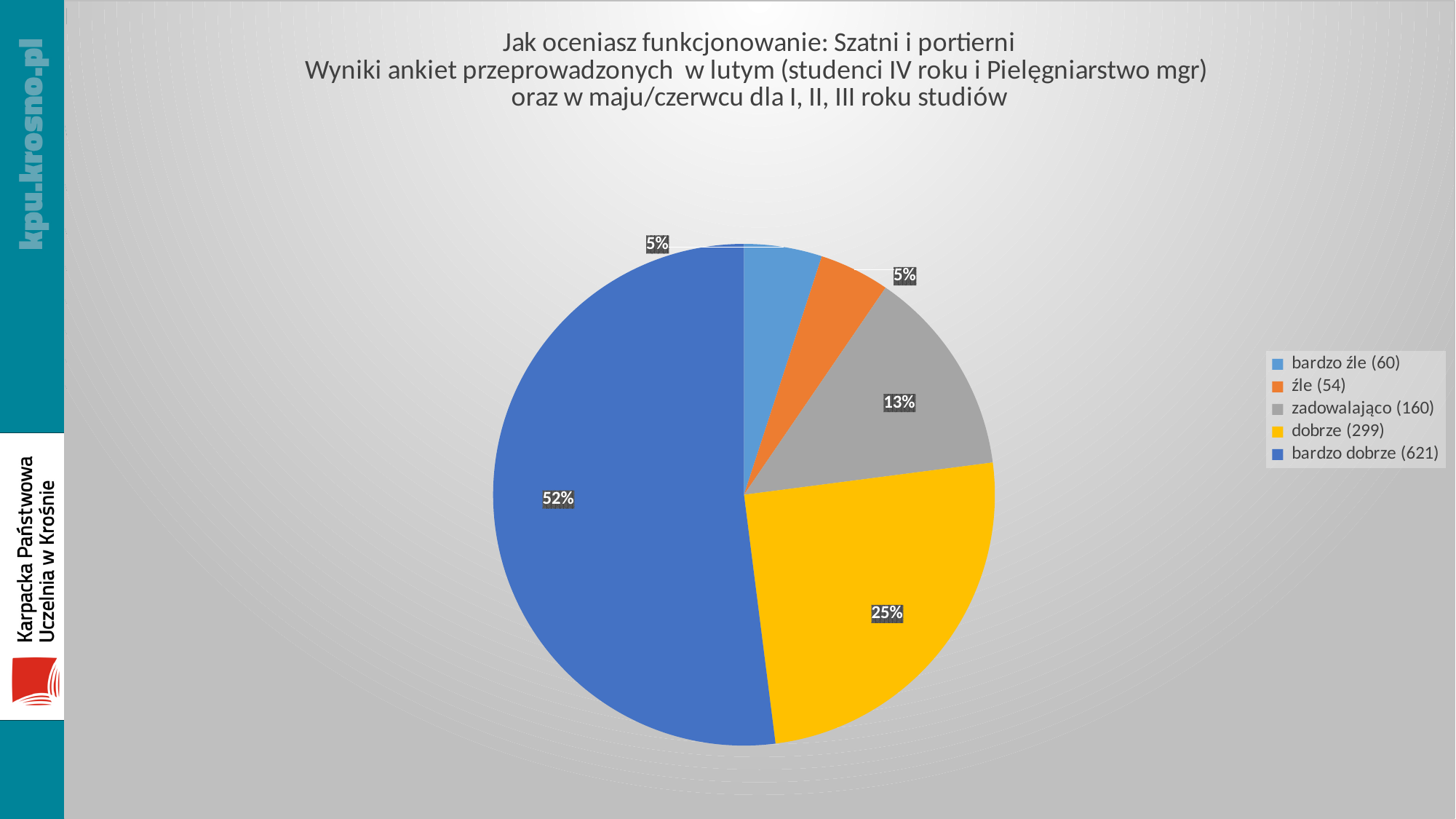
How many slices does the pie chart have? 5 Which slice is larger, "dobrze" or "zadowalająco"? dobrze Which category has the largest slice of the pie? bardzo dobrze What percentage share does the "bardzo dobrze" slice have? 52% What is the difference in percentage points between the "bardzo dobrze" and "dobrze" slices? 27 What kind of chart is shown on the slide? pie chart What colour is the "dobrze" slice? yellow What percentage share does the "zadowalająco" slice have? 13% How many responses does the legend show for "źle"? 54 How many responses does the legend show for "bardzo dobrze"? 621 What percentage share does the "dobrze" slice have? 25% How many responses does the legend show for "zadowalająco"? 160